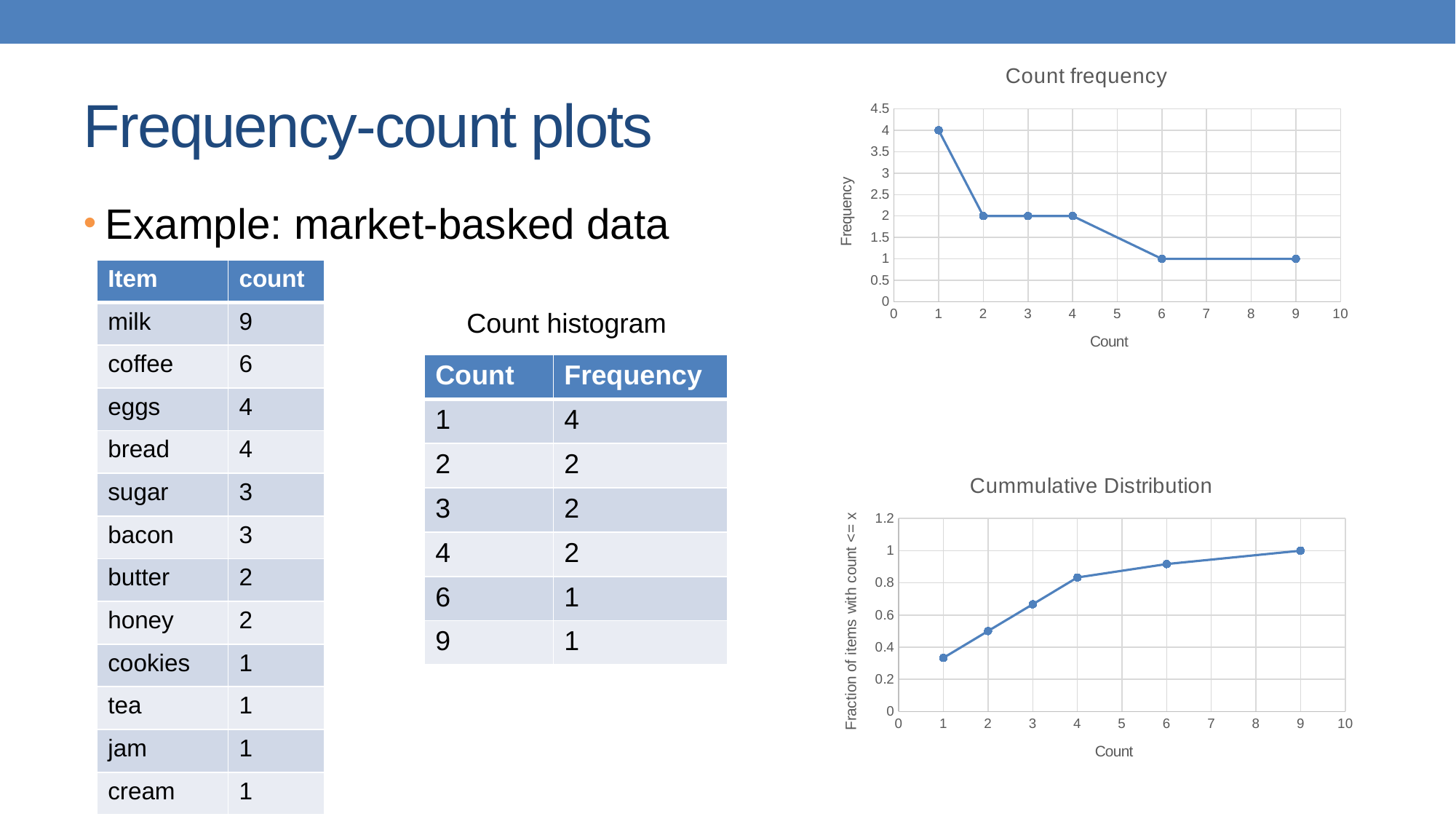
In the Cummulative Distribution chart, is the value at count 1 greater or less than 0.4? less In the Count frequency chart, which count has the highest frequency? 1 In the Cummulative Distribution chart, do the values rise or fall as count increases? rise In the Cummulative Distribution chart, what is the value at count 9? 1 In the Count frequency chart, what is the difference between the frequency at count 1 and the frequency at count 4? 2 In the Count frequency chart, how many data points are plotted? 6 In the Count frequency chart, what is the frequency for count 6? 1 In the Count frequency chart, do the frequency values rise or fall as count increases? fall In the Cummulative Distribution chart, is the value at count 4 greater or less than 0.8? greater What kind of chart is the Count frequency chart? line chart In the Count frequency chart, what is the frequency for count 1? 4 What is the y-axis label of the Cummulative Distribution chart? Fraction of items with count <= x